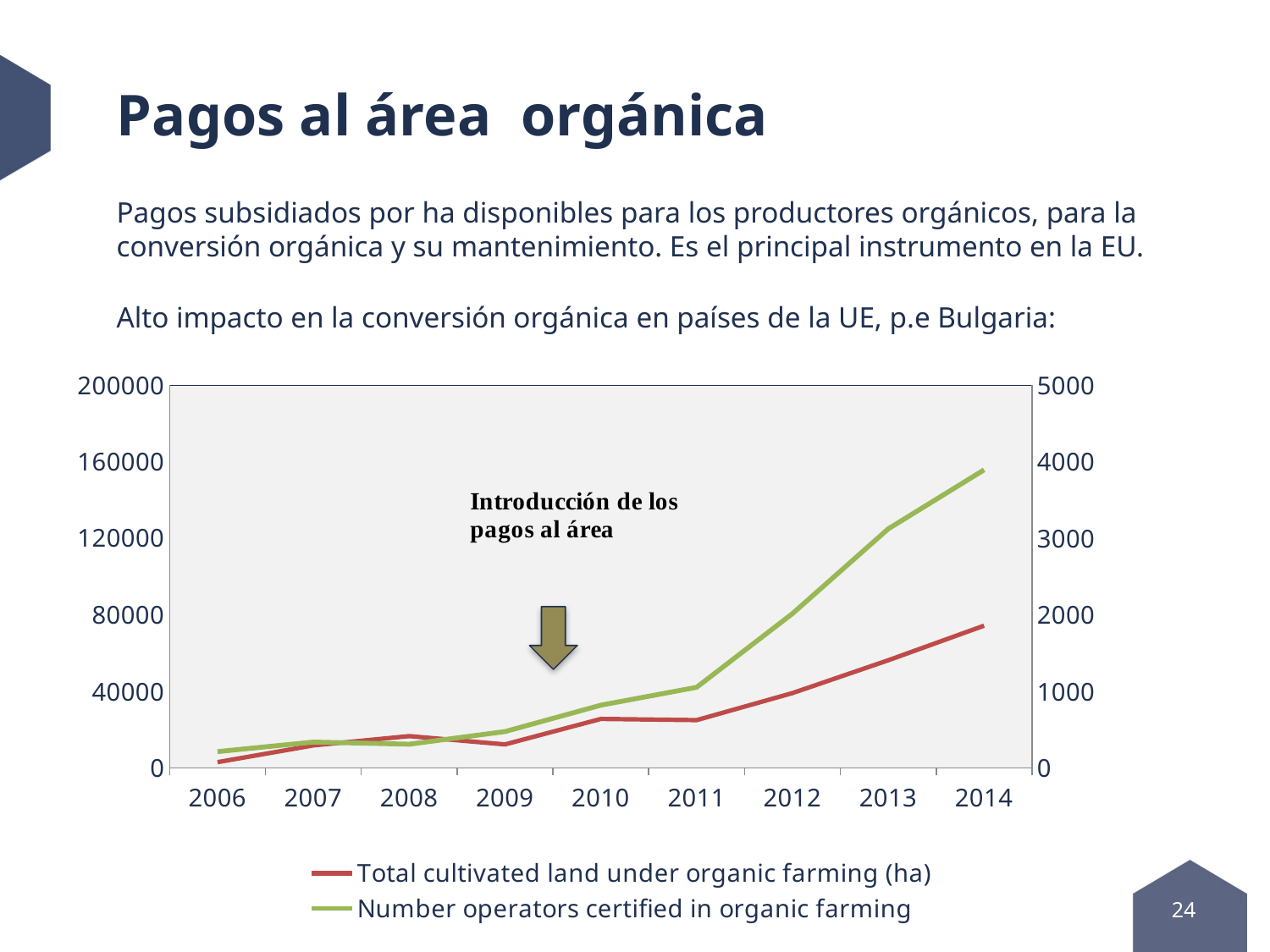
Is the 2010 value for 'Number operators certified in organic farming' greater or less than 1000 on the right axis? less Is the 2014 value for 'Number operators certified in organic farming' greater or less than 3000 on the right axis? greater How many series does the chart legend list? 2 Do the values for 'Number operators certified in organic farming' generally rise or fall from 2009 to 2014? Rise In which year is the value for 'Total cultivated land under organic farming (ha)' highest? 2014 How many years are plotted along the x axis of the chart? 9 Is the 2014 value for 'Total cultivated land under organic farming (ha)' greater or less than 80000? less What text does the annotation above the arrow in the chart say? Introducción de los pagos al área In which year is the value for 'Number operators certified in organic farming' highest? 2014 In which year is the value for 'Total cultivated land under organic farming (ha)' lowest? 2006 What kind of chart is shown on the slide? Line chart